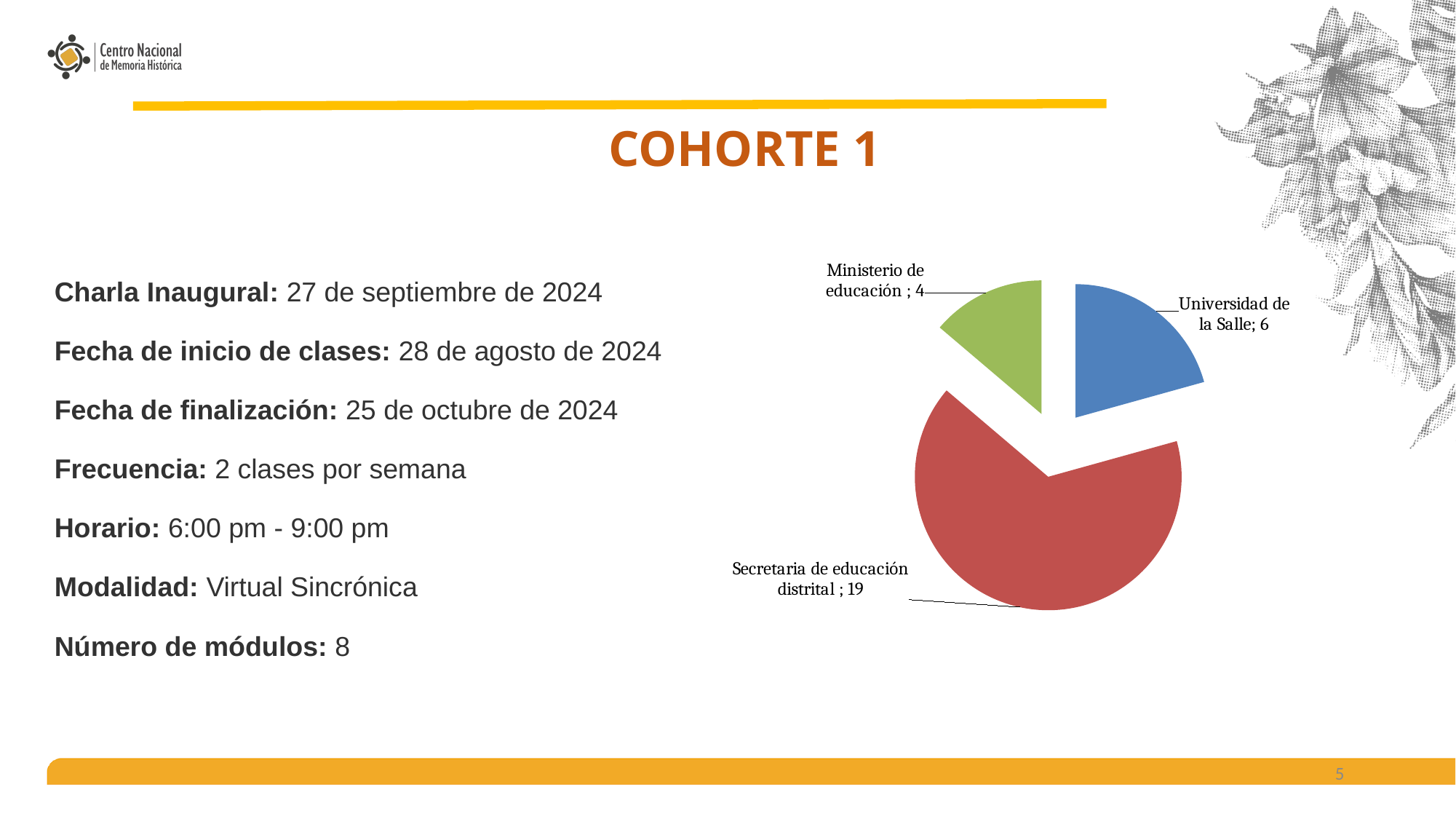
What is the difference between the values for Secretaria de educación distrital and Universidad de la Salle? 13 What colour is the slice for Secretaria de educación distrital? Red What is the total of all the values shown in the pie chart? 29 What is the value for Universidad de la Salle in the pie chart? 6 What is the difference between the values for Universidad de la Salle and Ministerio de educación? 2 Which category has the smallest slice in the pie chart? Ministerio de educación What type of chart is shown on the slide? Pie chart What is the value for Secretaria de educación distrital in the pie chart? 19 Which category has the largest slice in the pie chart? Secretaria de educación distrital What is the value for Ministerio de educación in the pie chart? 4 Which is larger, the value for Universidad de la Salle or the value for Ministerio de educación? Universidad de la Salle How many slices does the pie chart have? 3